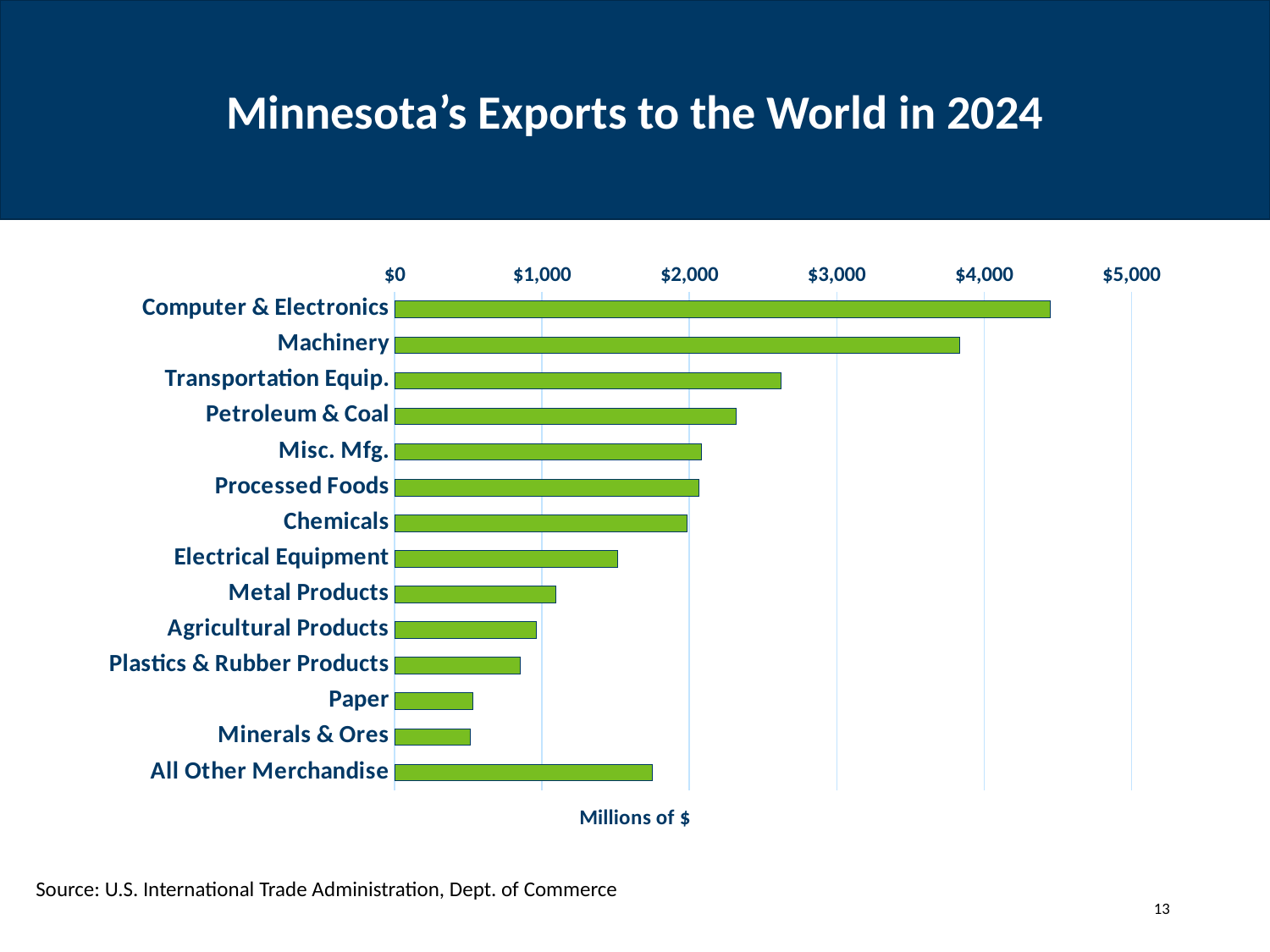
Is the value for Machinery greater or less than $3,000? greater How many categories are plotted in the chart? 14 What is the label on the horizontal axis of the chart? Millions of $ Is the value for Electrical Equipment greater or less than $2,000? less Which is larger, the value for Machinery or the value for Transportation Equip.? Machinery Is the value for Transportation Equip. greater or less than $2,000? greater What kind of chart is shown on the slide? bar chart Which is larger, the value for All Other Merchandise or the value for Metal Products? All Other Merchandise Which category has the highest export value? Computer & Electronics